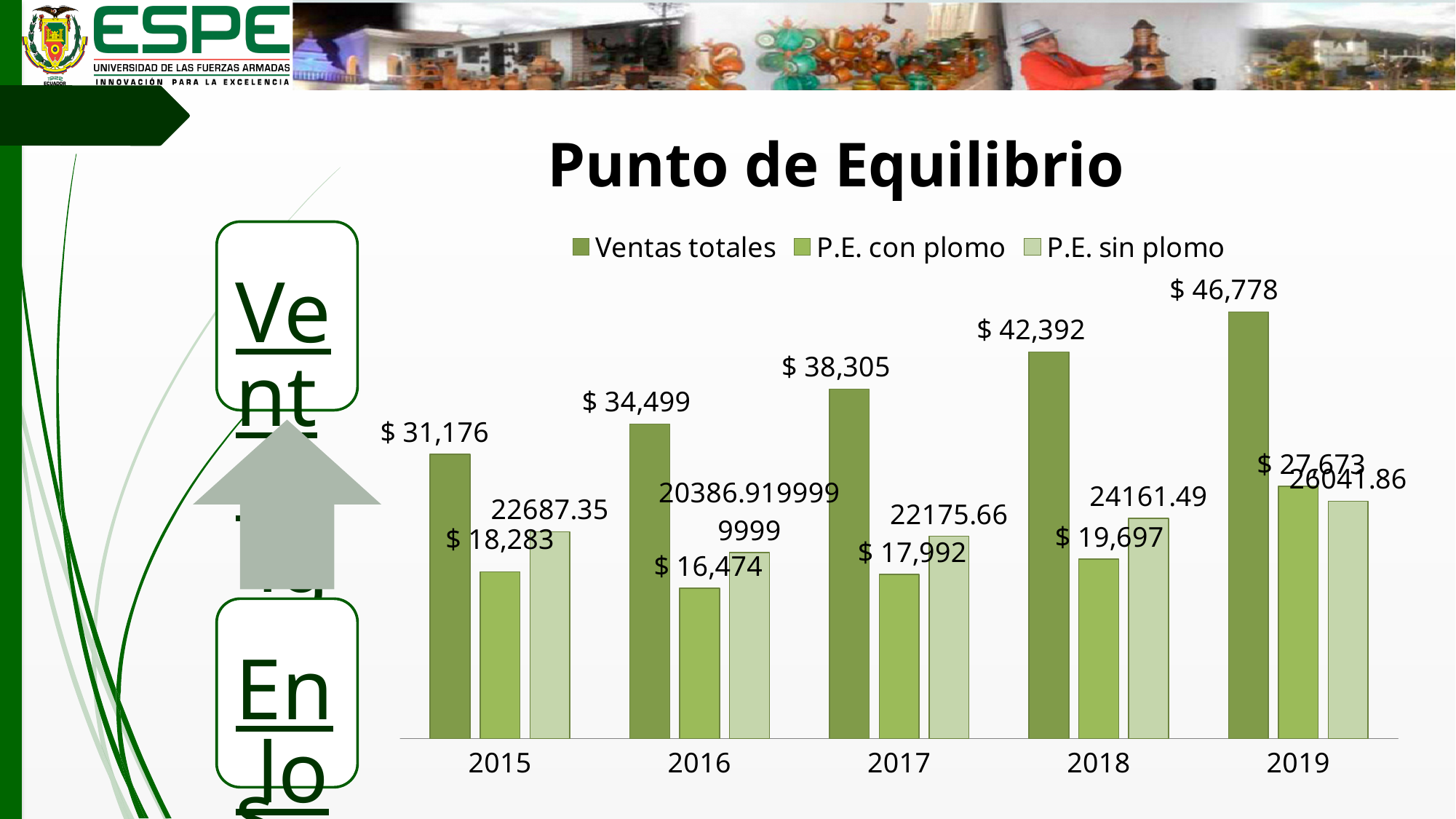
Which is larger, P.E. sin plomo in 2018 or in 2015? 2018 What is the difference between Ventas totales and P.E. con plomo in 2018? $ 22,695 What is the value of P.E. con plomo for 2015? $ 18,283 What kind of chart is shown on the slide? Bar chart What is the value of P.E. sin plomo for 2017? 22175.66 What is the value of Ventas totales for 2017? $ 38,305 In which year is Ventas totales highest? 2019 How many series does the legend list? 3 How many years are shown on the x axis? 5 Does Ventas totales rise or fall from 2015 to 2019? Rise What is the difference between Ventas totales in 2019 and in 2015? $ 15,602 In which year is P.E. con plomo lowest? 2016